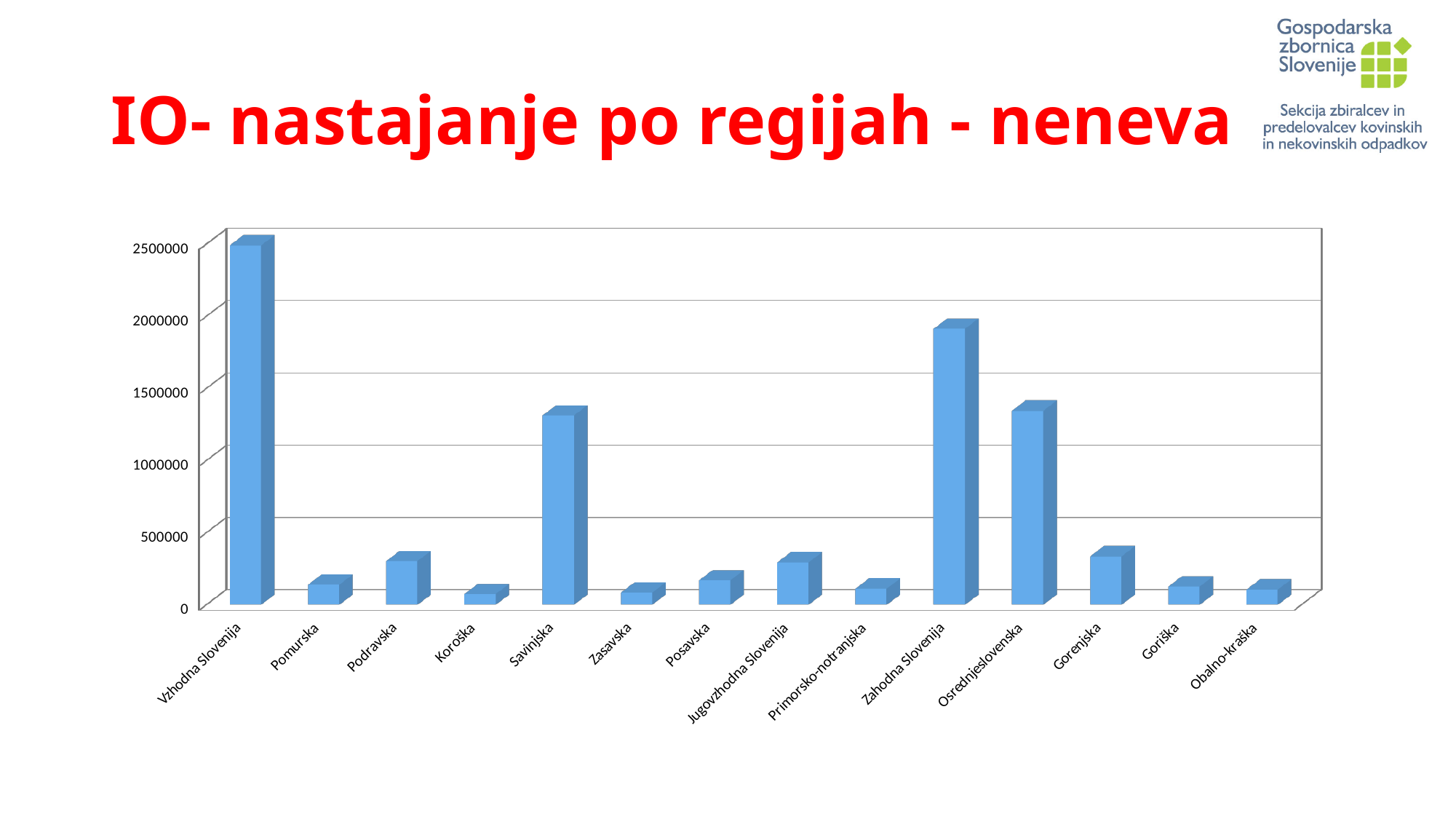
Is the value for Osrednjeslovenska greater or less than 1000000? greater How many regions (categories) are shown on the x axis of the chart? 14 Which is larger, the value for Vzhodna Slovenija or the value for Zahodna Slovenija? Vzhodna Slovenija Is the value for Vzhodna Slovenija greater or less than 2000000? greater Is the value for Savinjska greater or less than 1000000? greater Which region has the highest bar in the chart? Vzhodna Slovenija Which is larger, the value for Savinjska or the value for Podravska? Savinjska What is the title of the slide containing the chart? IO- nastajanje po regijah - neneva What kind of chart is shown on the slide? bar chart